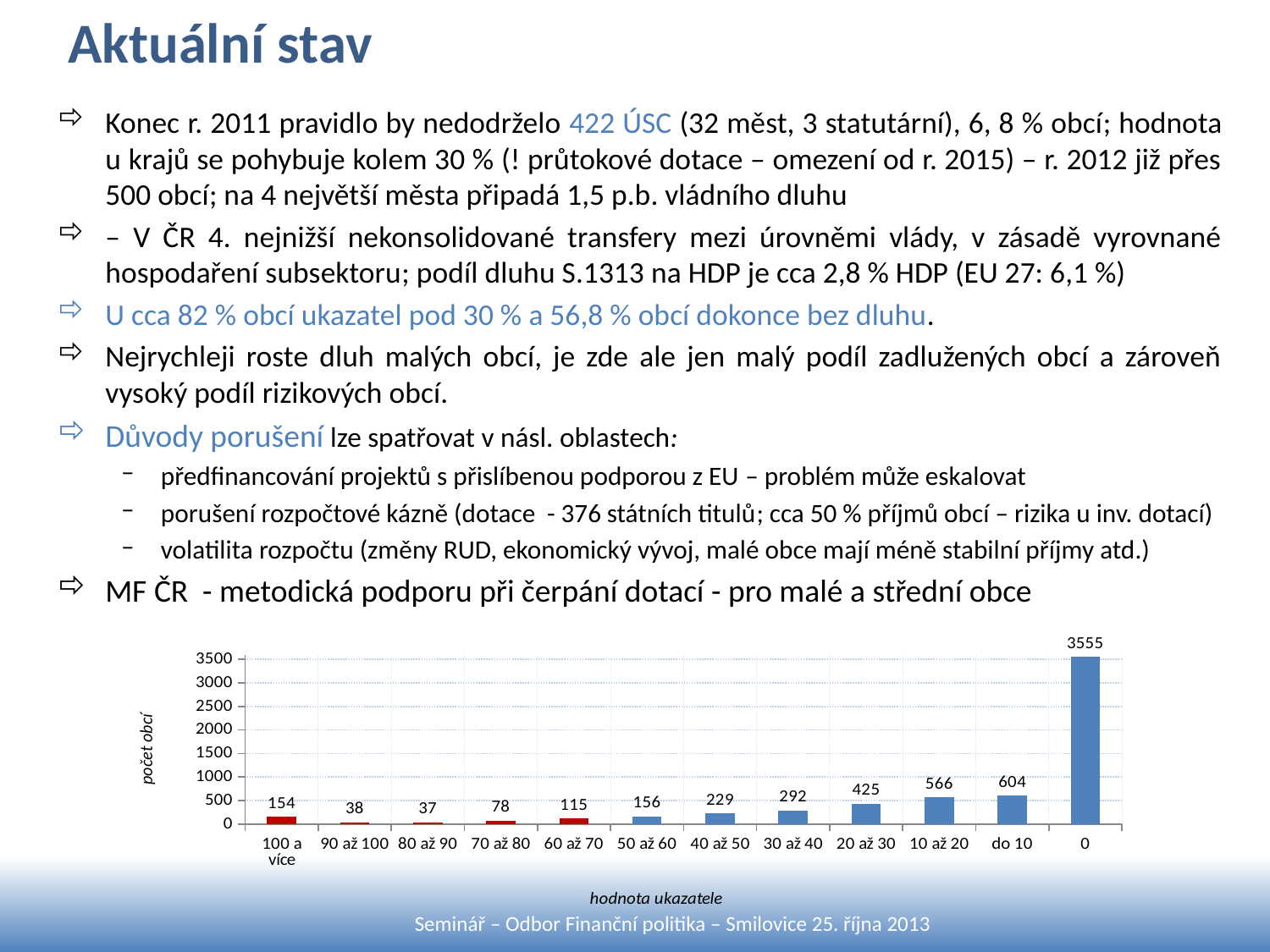
How many bars are coloured red? 5 Which category has the highest value? 0 What is the value for the category "100 a více"? 154 Which category has the lowest value? 80 až 90 Is the value for "0" greater or less than 3000? greater What is the difference between the values for "10 až 20" and "20 až 30"? 141 What is the value for the category "0"? 3555 How many categories are shown on the x axis? 12 What kind of chart is shown on the slide? bar chart What is the value for the category "do 10"? 604 What is the label of the vertical axis? počet obcí Which is larger, the value for "60 až 70" or the value for "50 až 60"? 50 až 60